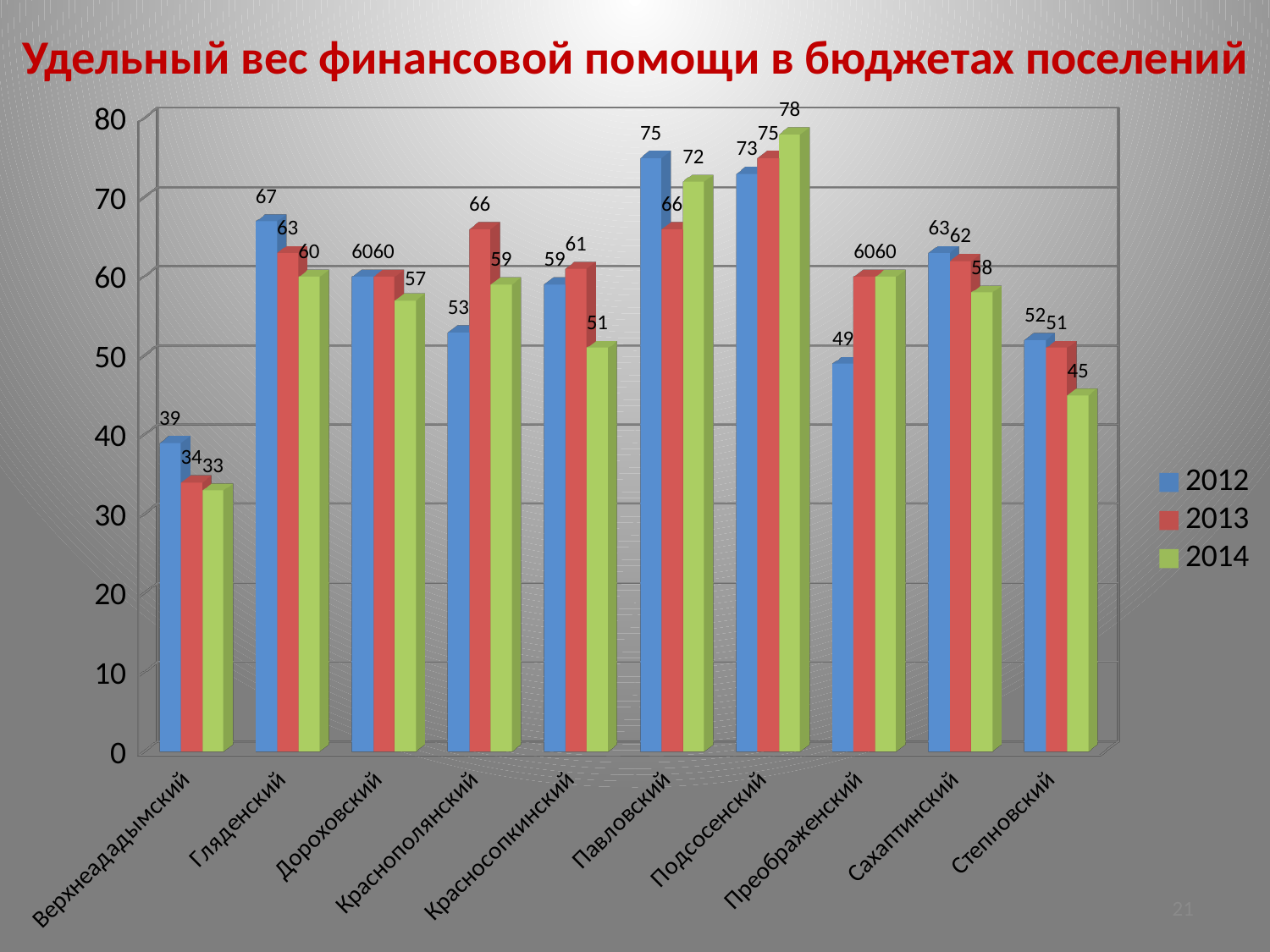
What is the difference between the 2012 and 2014 values for Степновский? 7 What is the value for Подсосенский in 2014? 78 What kind of chart is shown on the slide? bar chart Which category has the lowest value in the 2012 series? Верхнеададымский Which is larger for Павловский: the 2012 value or the 2013 value? 2012 How many categories (settlements) are shown on the x axis? 10 How many series does the legend list? 3 Do the values for Гляденский rise or fall from 2012 to 2014? fall What is the value for Преображенский in 2012? 49 What is the title of the chart? Удельный вес финансовой помощи в бюджетах поселений What is the value for Краснополянский in 2013? 66 Which category has the highest value in the 2014 series? Подсосенский